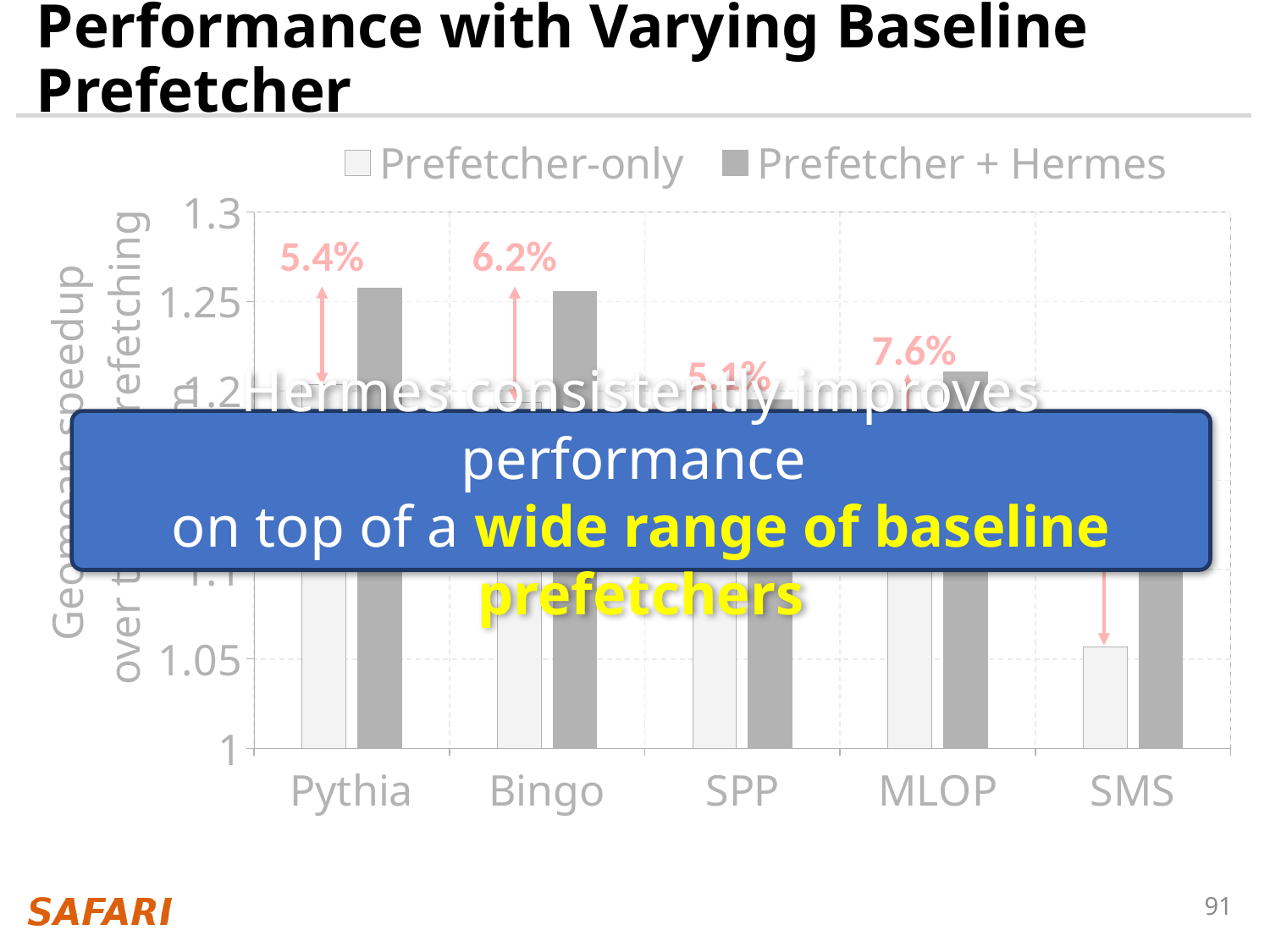
What improvement percentage is labeled above the Bingo bars? 6.2% What improvement percentage is labeled above the MLOP bars? 7.6% What improvement percentage is labeled above the Pythia bars? 5.4% Of Pythia, Bingo, SPP and MLOP, which has the lowest labeled improvement percentage? SPP How many series does the legend list? 2 What is the difference between the labeled improvement percentages for MLOP and Pythia? 2.2% What improvement percentage is labeled above the SPP bars? 5.1% What kind of chart is shown on the slide? bar chart Of Pythia, Bingo, SPP and MLOP, which has the highest labeled improvement percentage? MLOP Is the Prefetcher + Hermes value for MLOP greater or less than 1.2? greater How many baseline prefetchers are shown on the x axis? 5 Which is larger, the Prefetcher + Hermes value for Pythia or for MLOP? Pythia